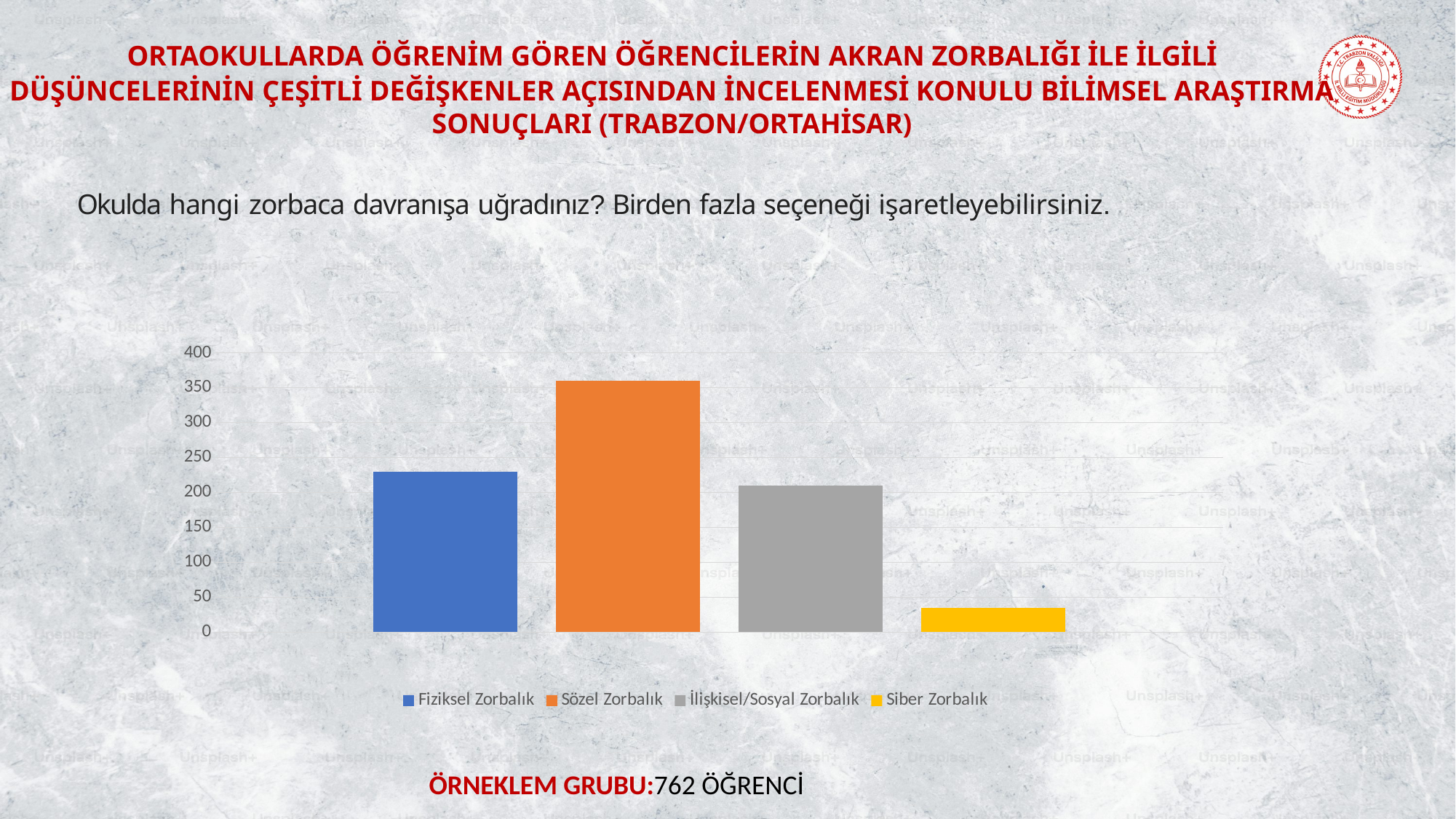
Is the value for Sözel Zorbalık greater or less than 300? greater What colour is the bar for Siber Zorbalık? yellow Is the value for Siber Zorbalık greater or less than 50? less Is the value for İlişkisel/Sosyal Zorbalık greater or less than 250? less How many bars are plotted in the chart? 4 What kind of chart is shown on the slide? bar chart How many series does the legend list? 4 Which is larger, the value for Sözel Zorbalık or the value for İlişkisel/Sosyal Zorbalık? Sözel Zorbalık Which category has the highest bar? Sözel Zorbalık Which category has the lowest bar? Siber Zorbalık